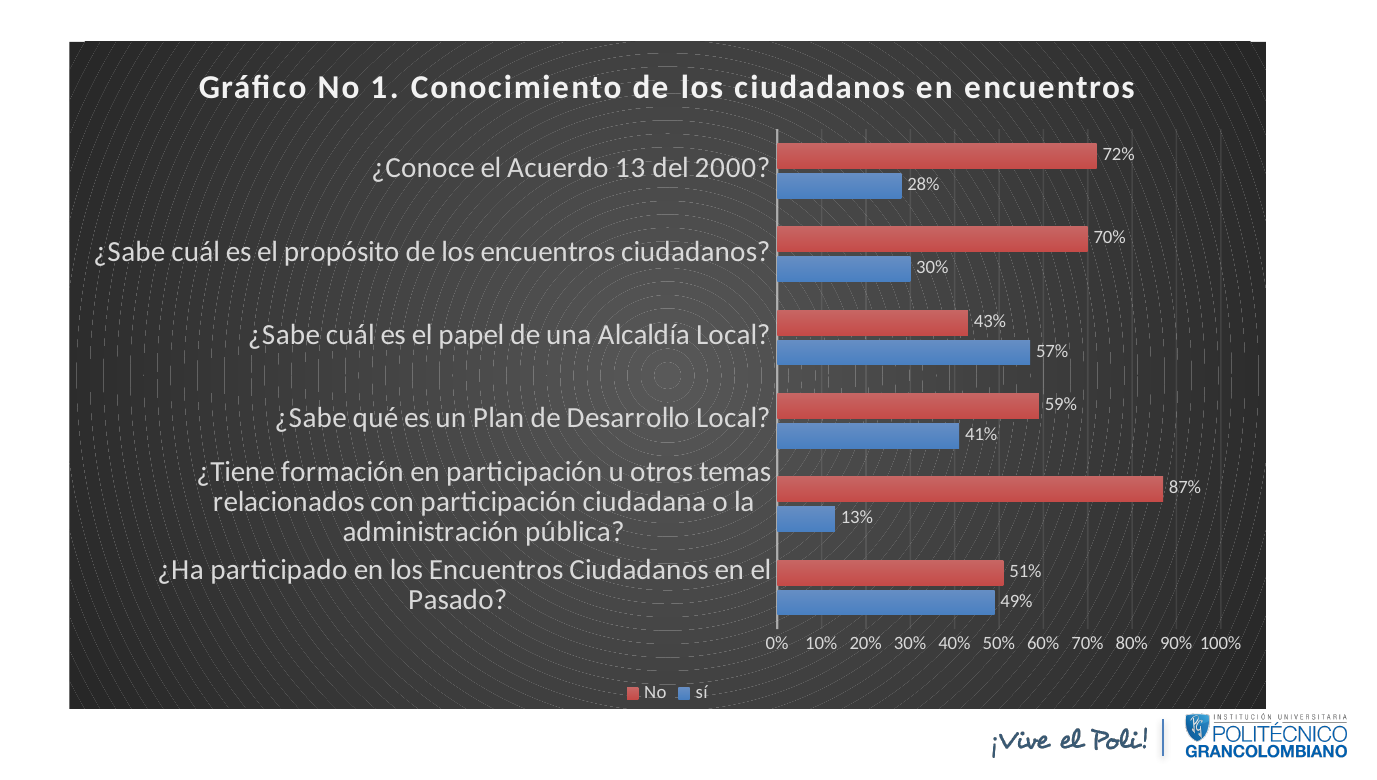
What kind of chart is shown on the slide? Bar chart Which colour represents the "No" series in the legend? Red What percentage answered "sí" to "¿Sabe cuál es el papel de una Alcaldía Local?"? 57% What is the title of the chart? Gráfico No 1. Conocimiento de los ciudadanos en encuentros Which question has the lowest "sí" percentage? ¿Tiene formación en participación u otros temas relacionados con participación ciudadana o la administración pública? Which question has the highest "No" percentage? ¿Tiene formación en participación u otros temas relacionados con participación ciudadana o la administración pública? What percentage answered "sí" to "¿Tiene formación en participación u otros temas relacionados con participación ciudadana o la administración pública?"? 13% What is the difference between the "No" and "sí" percentages for "¿Sabe qué es un Plan de Desarrollo Local?"? 18% What percentage answered "No" to "¿Conoce el Acuerdo 13 del 2000?"? 72% How many questions (categories) are shown on the chart? 6 For "¿Sabe cuál es el papel de una Alcaldía Local?", which is larger, the "No" or the "sí" percentage? sí How many series does the legend list? 2